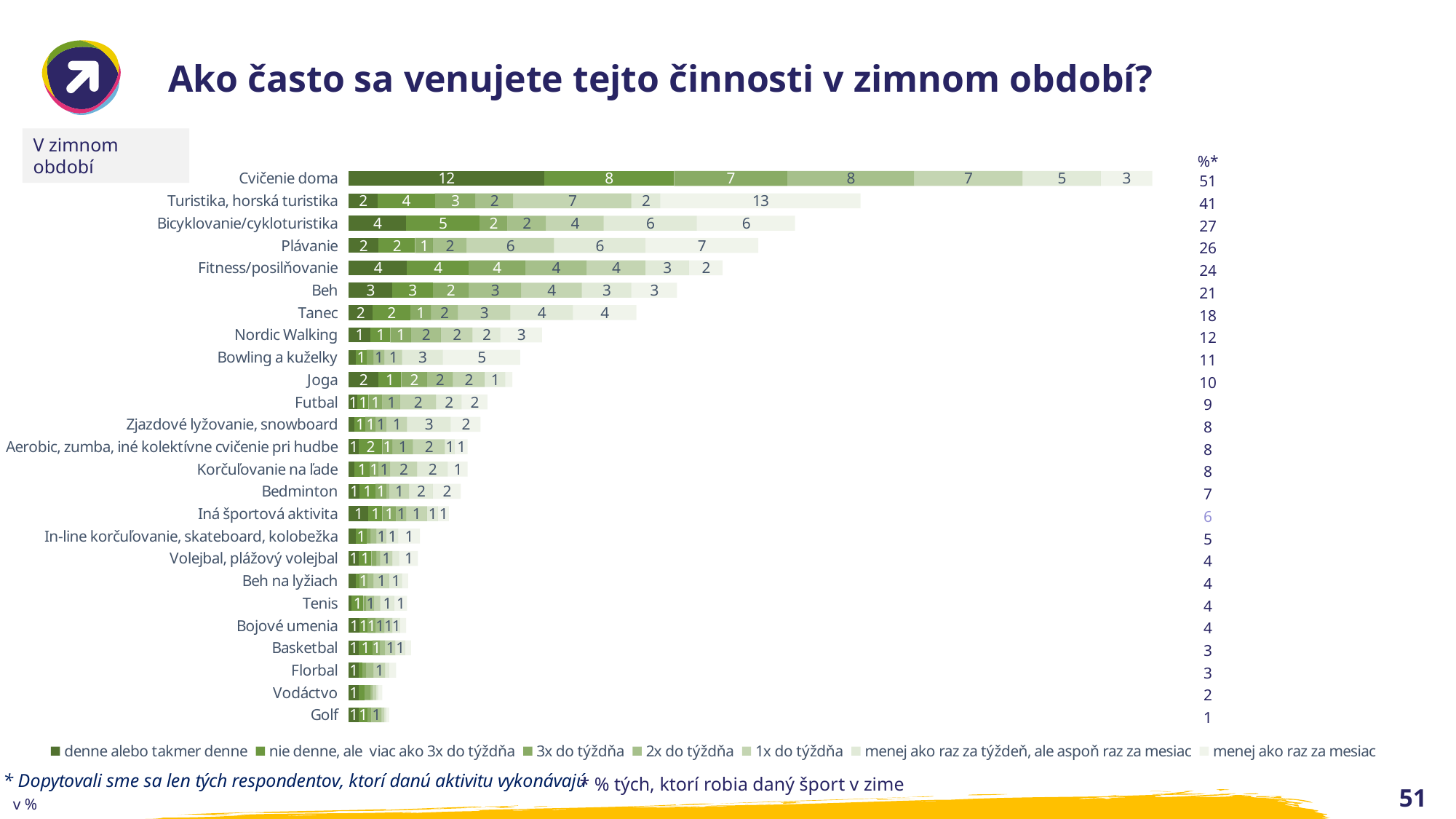
What is the value of the 'menej ako raz za mesiac' segment for Plávanie? 7 What is the value of the 'denne alebo takmer denne' segment for Cvičenie doma? 12 Which is larger: the 'denne alebo takmer denne' value for Cvičenie doma or for Bicyklovanie/cykloturistika? Cvičenie doma How many series does the legend list? 7 What is the total of all segments in the stacked bar for Tanec? 18 What is the title of the chart on the slide? Ako často sa venujete tejto činnosti v zimnom období? What kind of chart is shown on the slide? Stacked bar chart How many activity categories are plotted in the chart? 25 Which activity has the longest stacked bar overall? Cvičenie doma What is the value of the 'menej ako raz za mesiac' segment for Turistika, horská turistika? 13 What is the difference between the 'denne alebo takmer denne' values for Cvičenie doma (12) and Fitness/posilňovanie (4)? 8 What is the value of the 'nie denne, ale viac ako 3x do týždňa' segment for Bicyklovanie/cykloturistika? 5